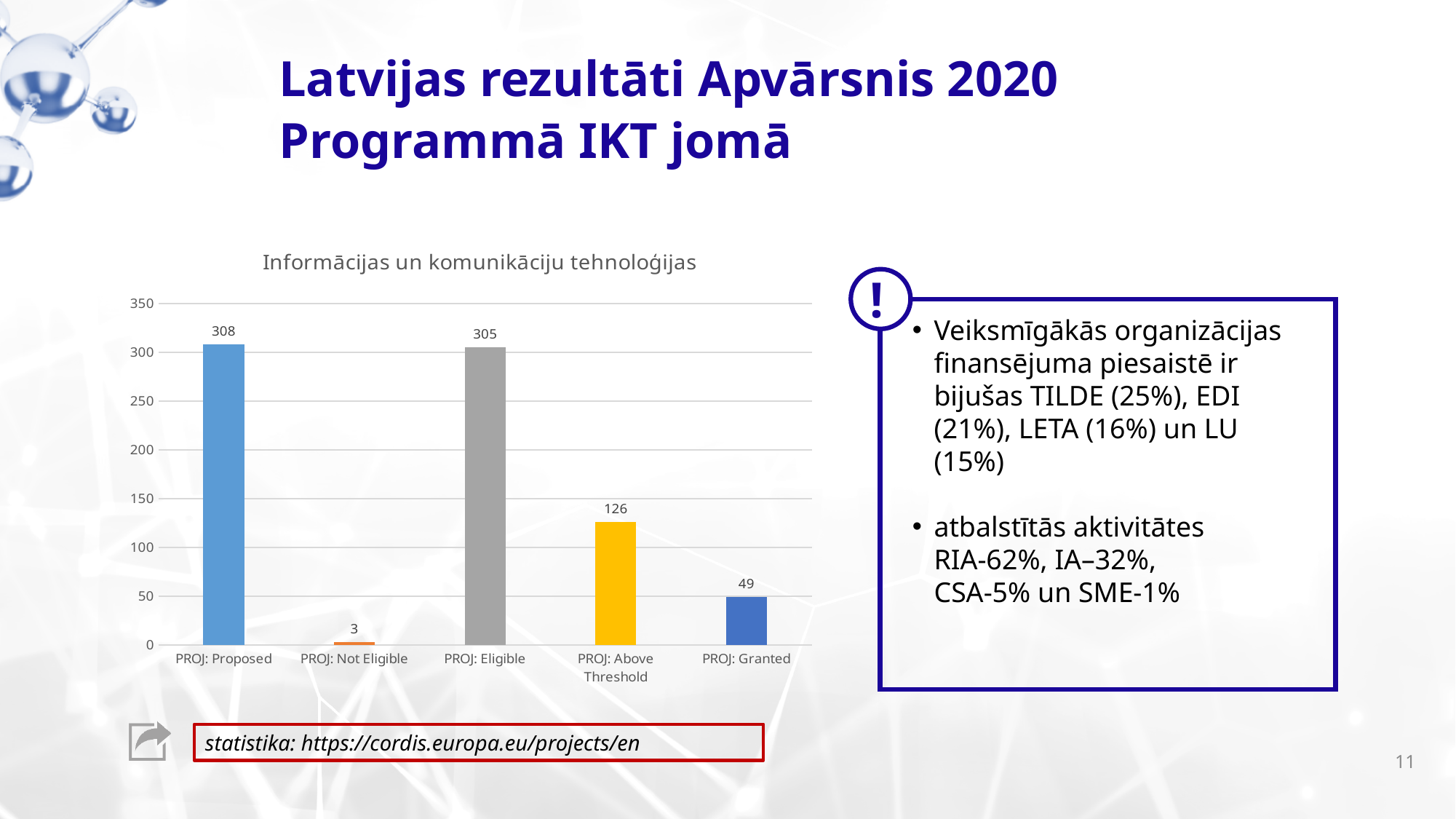
How many categories are shown in the chart? 5 Which category has the lowest value? PROJ: Not Eligible What is the difference between PROJ: Proposed and PROJ: Eligible? 3 Which category has the highest value? PROJ: Proposed What is the value for PROJ: Above Threshold? 126 Which is larger, PROJ: Above Threshold or PROJ: Granted? PROJ: Above Threshold What is the value for PROJ: Eligible? 305 What is the difference between PROJ: Above Threshold and PROJ: Granted? 77 What is the value for PROJ: Granted? 49 What is the value for PROJ: Proposed? 308 What is the value for PROJ: Not Eligible? 3 What is the title of the chart? Informācijas un komunikāciju tehnoloģijas